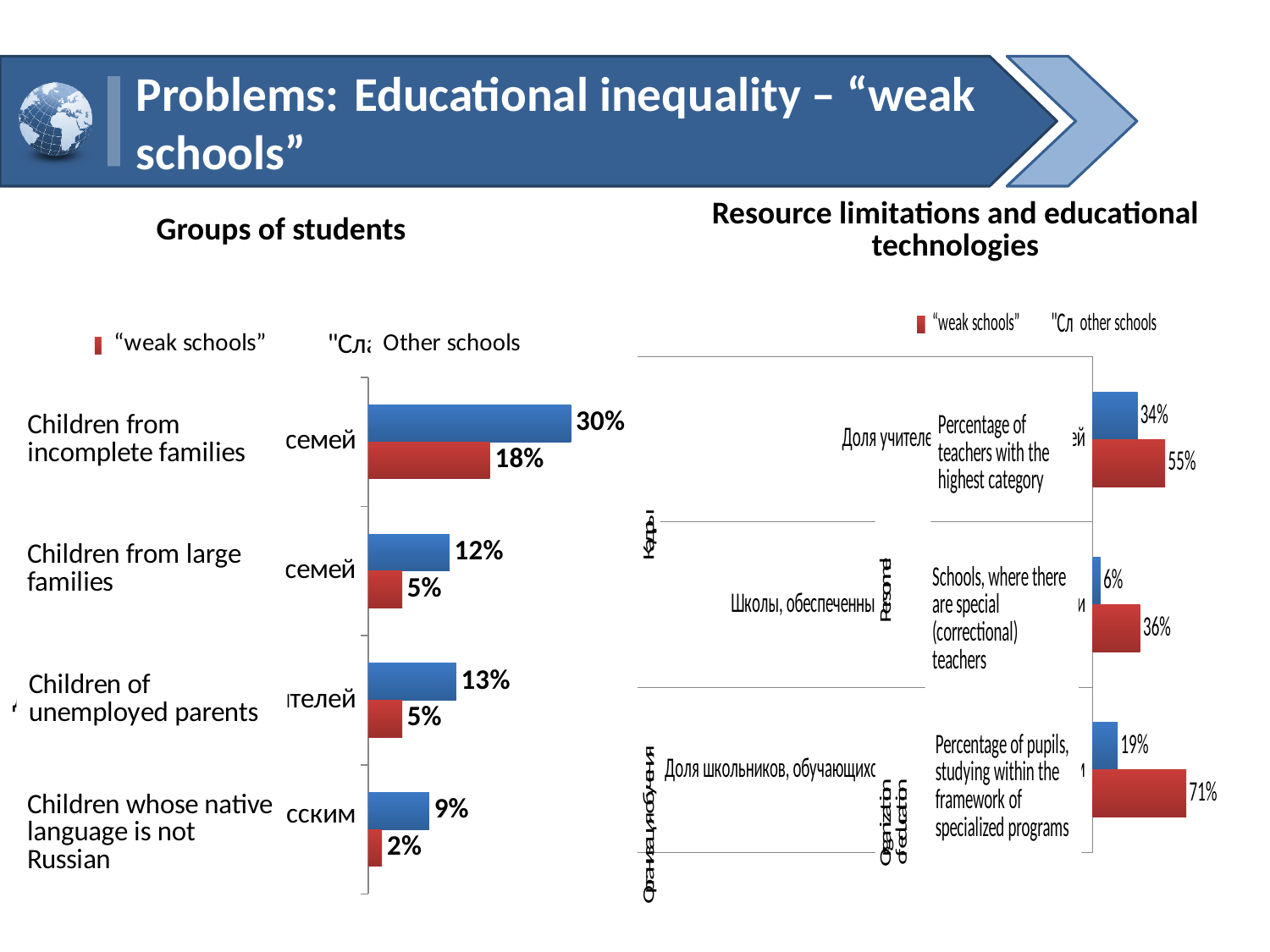
In the "Groups of students" chart, what is the value of the red bar for children whose native language is not Russian? 2% In the "Resource limitations and educational technologies" chart, how many series does the legend list? 2 What type of chart is the "Groups of students" chart? Bar chart In the "Resource limitations and educational technologies" chart, what is the value of the red bar for percentage of teachers with the highest category? 55% In the "Groups of students" chart, what is the difference between the blue and red bars for children of unemployed parents? 8% In the "Resource limitations and educational technologies" chart, which category has the highest red bar? Percentage of pupils, studying within the framework of specialized programs In the "Groups of students" chart, which category has the highest blue bar? Children from incomplete families In the "Groups of students" chart, what is the value of the blue bar for children from incomplete families? 30% In the "Groups of students" chart, how many categories are shown? 4 In the "Groups of students" chart, what is the value of the red bar for children from large families? 5% In the "Resource limitations and educational technologies" chart, what is the difference between the red and blue bars for percentage of pupils studying within the framework of specialized programs? 52% In the "Resource limitations and educational technologies" chart, what is the value of the blue bar for schools where there are special (correctional) teachers? 6%